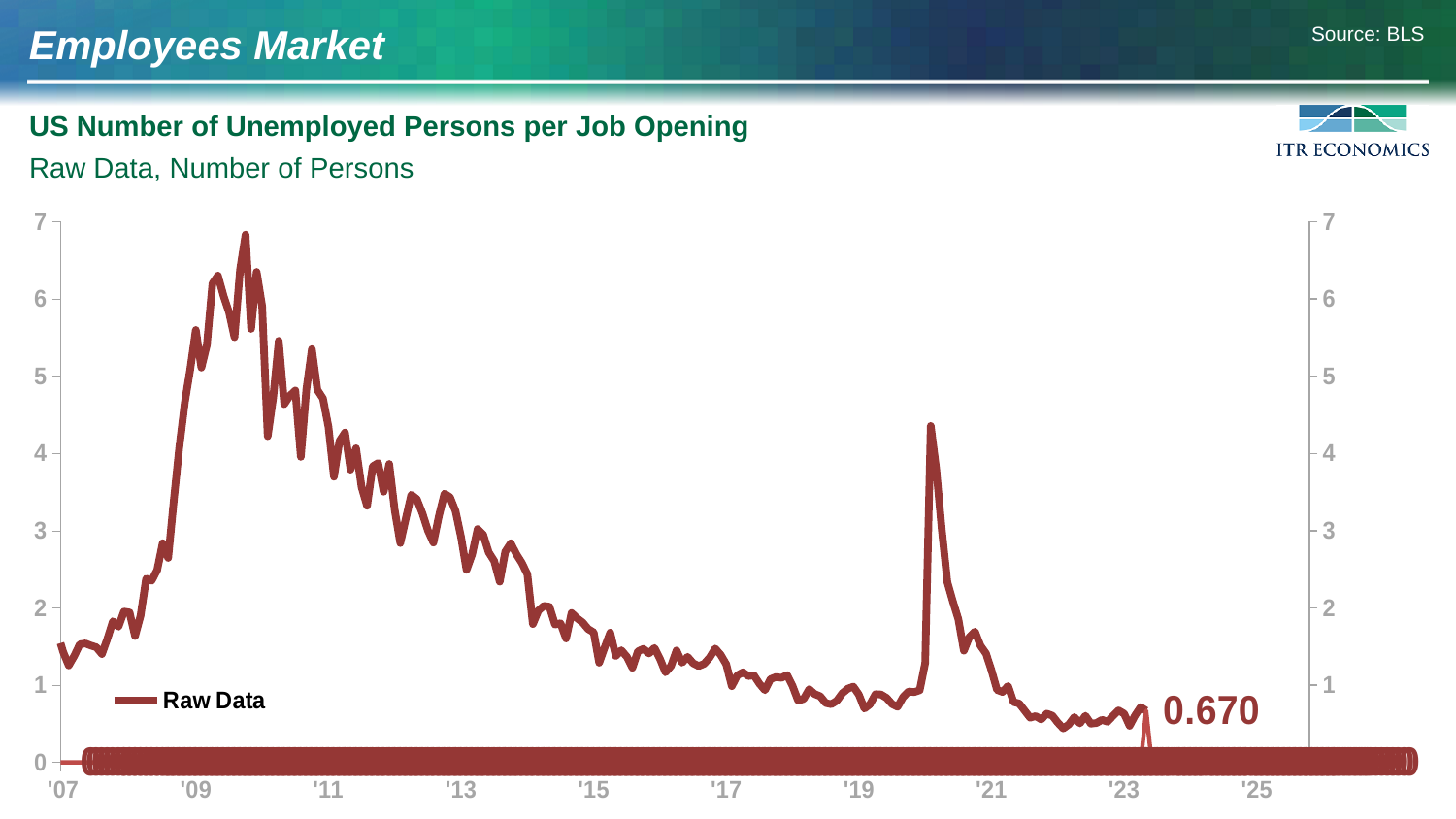
What is the title of the chart? US Number of Unemployed Persons per Job Opening Is the value around '13 greater or less than 2? greater What is the name of the series shown in the legend? Raw Data What is the latest value labeled on the line? 0.670 How many series does the legend list? 1 Is the value at the start of the series in '07 greater or less than 2? less Is the peak value of the line around 2009 greater or less than 6? greater Does the line rise or fall between '07 and '09? rise Does the line generally rise or fall between '11 and '19? fall What kind of chart is shown on the slide? line chart